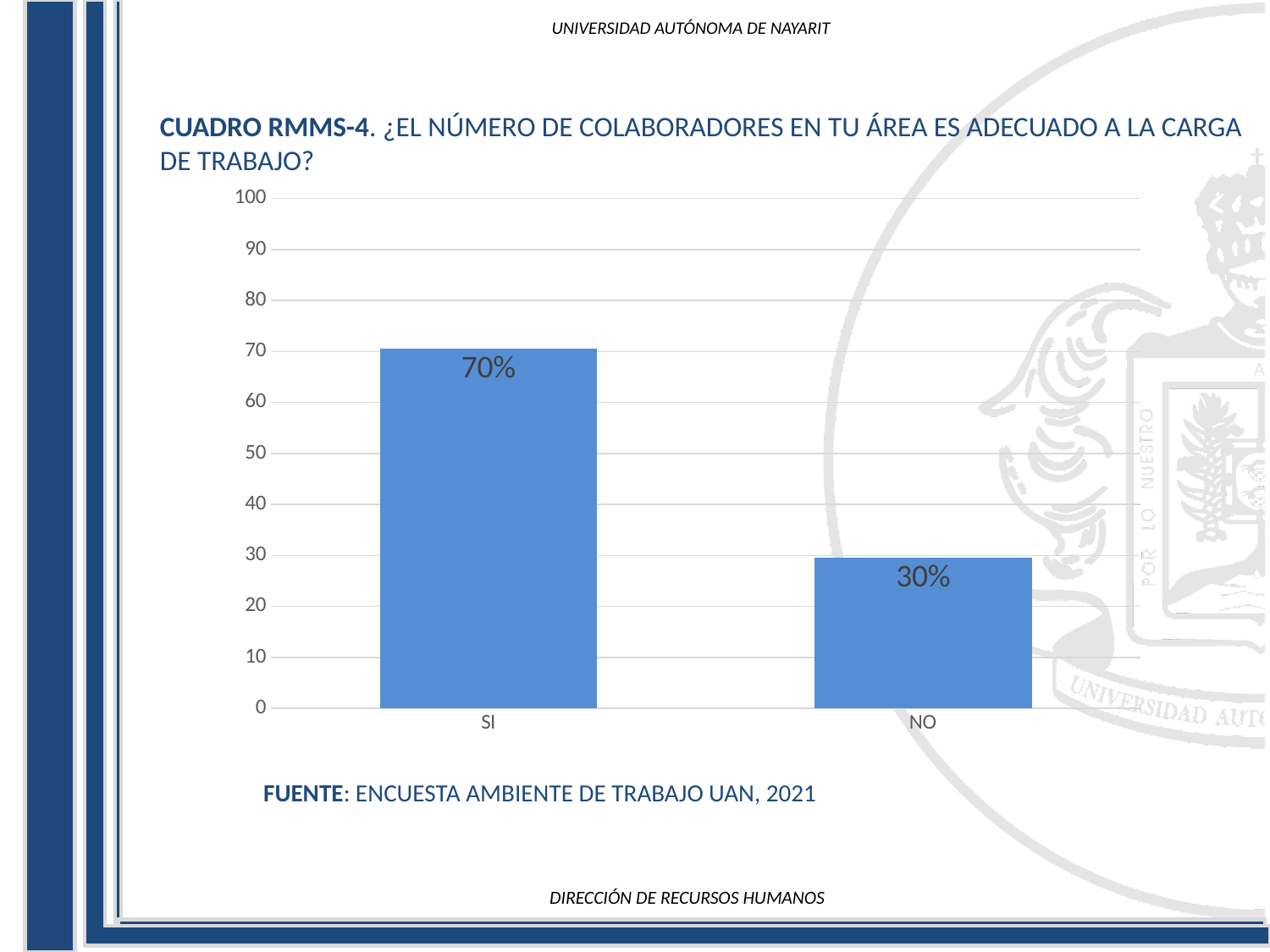
What is the value for SI? 70% Which category has the highest value? SI Is the value for SI greater or less than 60? greater What kind of chart is shown on the slide? bar chart What is the value for NO? 30% Which is larger, the value for SI or the value for NO? SI What is the maximum value shown on the y axis? 100 Is the value for NO greater or less than 50? less What is the difference between the values for SI and NO? 40% What source is cited below the chart? ENCUESTA AMBIENTE DE TRABAJO UAN, 2021 How many categories are shown on the x axis? 2 Which category has the lowest value? NO